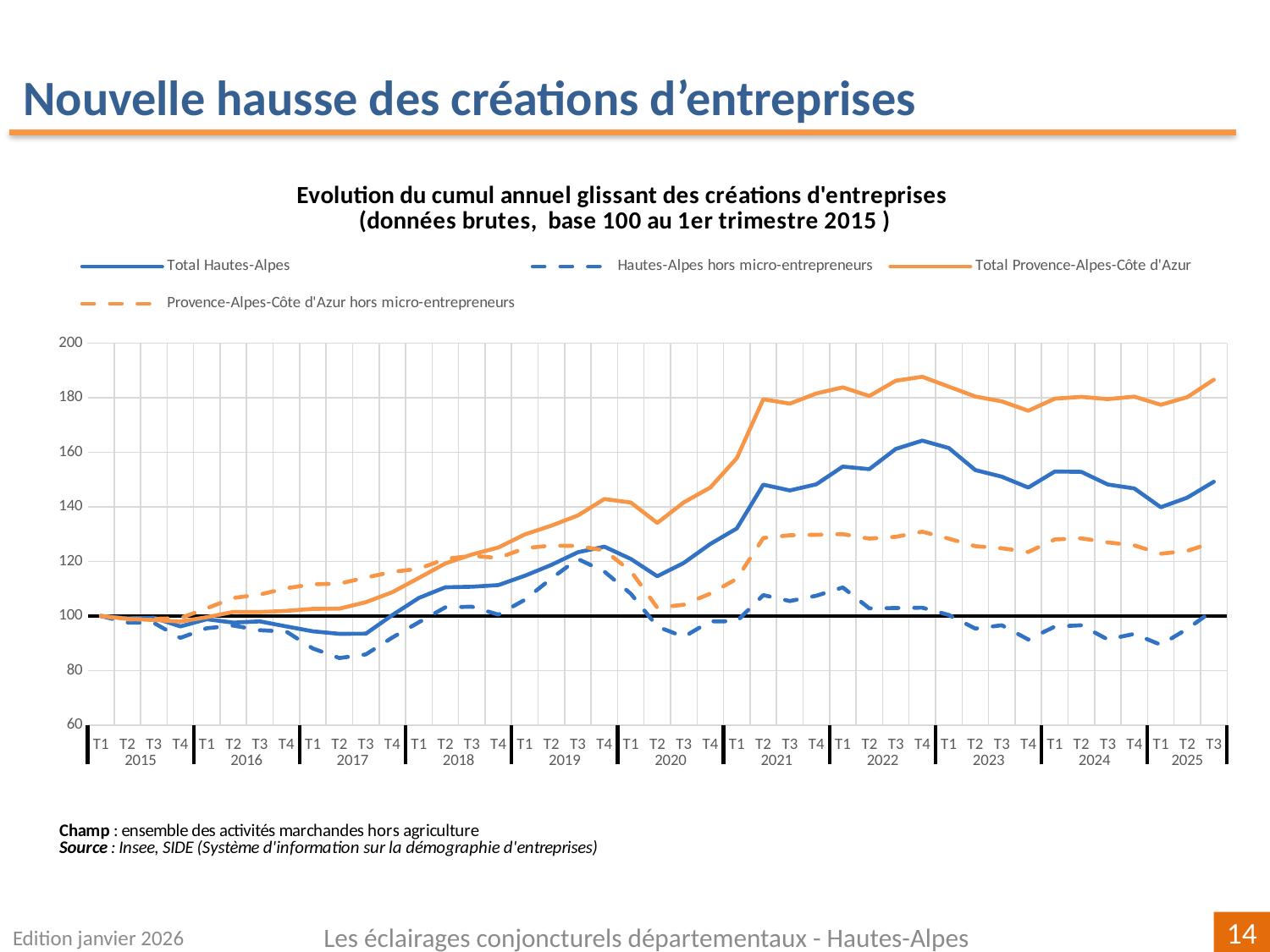
What kind of chart is shown on the slide? line chart How many quarterly points are plotted for each series, from T1 2015 to T3 2025? 43 How many years are labelled along the x axis? 11 What is the base value and reference period stated in the chart title? base 100 au 1er trimestre 2015 Is the value for Hautes-Alpes hors micro-entrepreneurs at T2 2017 greater or less than 90? less How many series does the legend list? 4 Which series has the highest value at T4 2022? Total Provence-Alpes-Côte d'Azur Is the value for Total Provence-Alpes-Côte d'Azur at T3 2025 greater or less than 180? greater At T3 2025, which is higher: Total Provence-Alpes-Côte d'Azur or Total Hautes-Alpes? Total Provence-Alpes-Côte d'Azur Is the value for Provence-Alpes-Côte d'Azur hors micro-entrepreneurs at T4 2022 greater or less than 120? greater Does the Total Provence-Alpes-Côte d'Azur series rise or fall between T1 2015 and T4 2019? rise